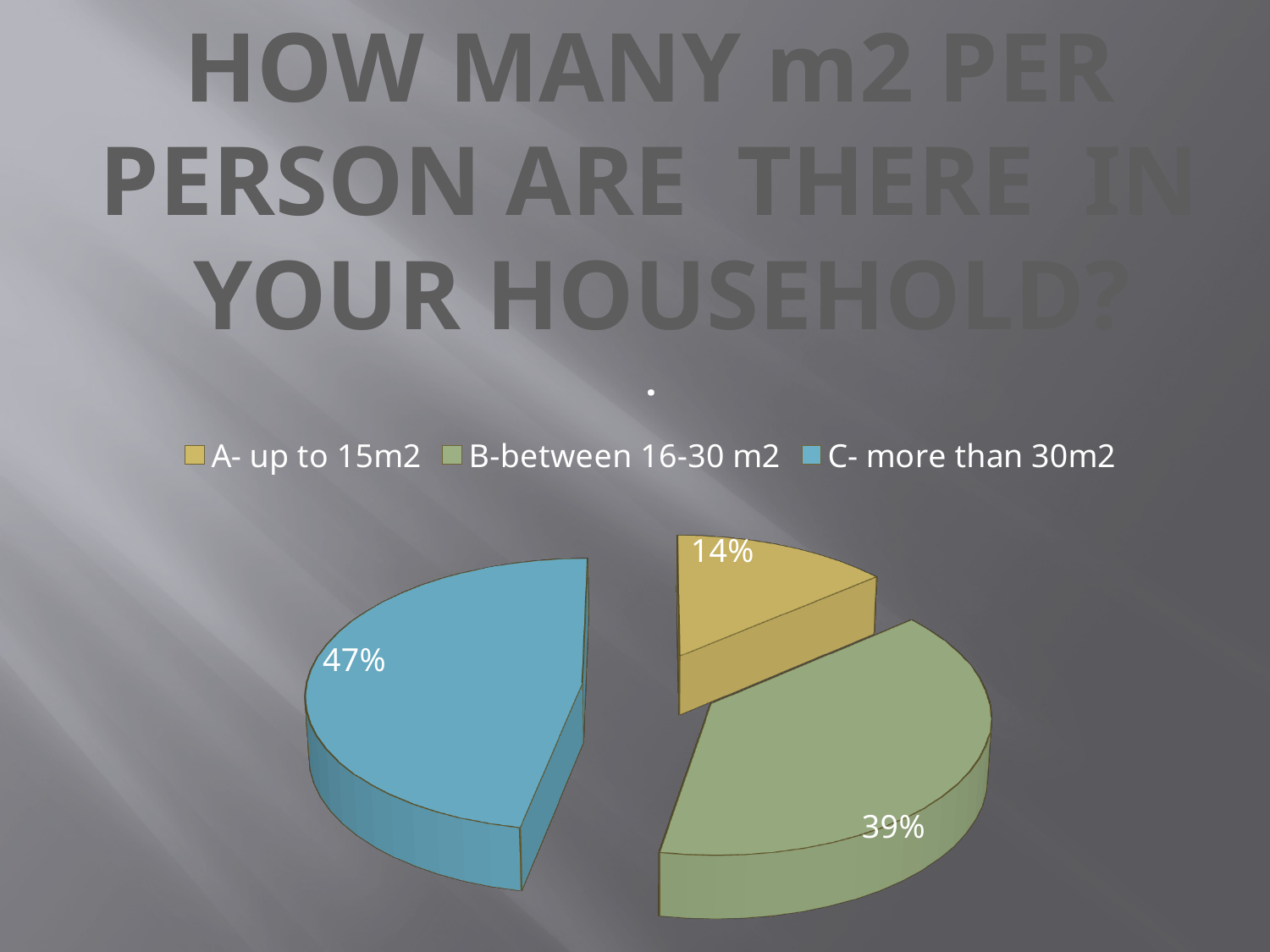
How many entries does the legend list? 3 How many slices does the pie chart have? 3 What share of the pie does 'C- more than 30m2' have? 47% What share of the pie does 'B-between 16-30 m2' have? 39% What share of the pie does 'A- up to 15m2' have? 14% What kind of chart is shown on the slide? pie chart Which category has the largest slice of the pie? C- more than 30m2 What colour is the slice for 'C- more than 30m2'? blue What is the difference in percentage points between 'C- more than 30m2' and 'B-between 16-30 m2'? 8 Which category has the smallest slice of the pie? A- up to 15m2 What is the difference in percentage points between 'B-between 16-30 m2' and 'A- up to 15m2'? 25 Which is larger: the slice for 'A- up to 15m2' or the slice for 'B-between 16-30 m2'? B-between 16-30 m2